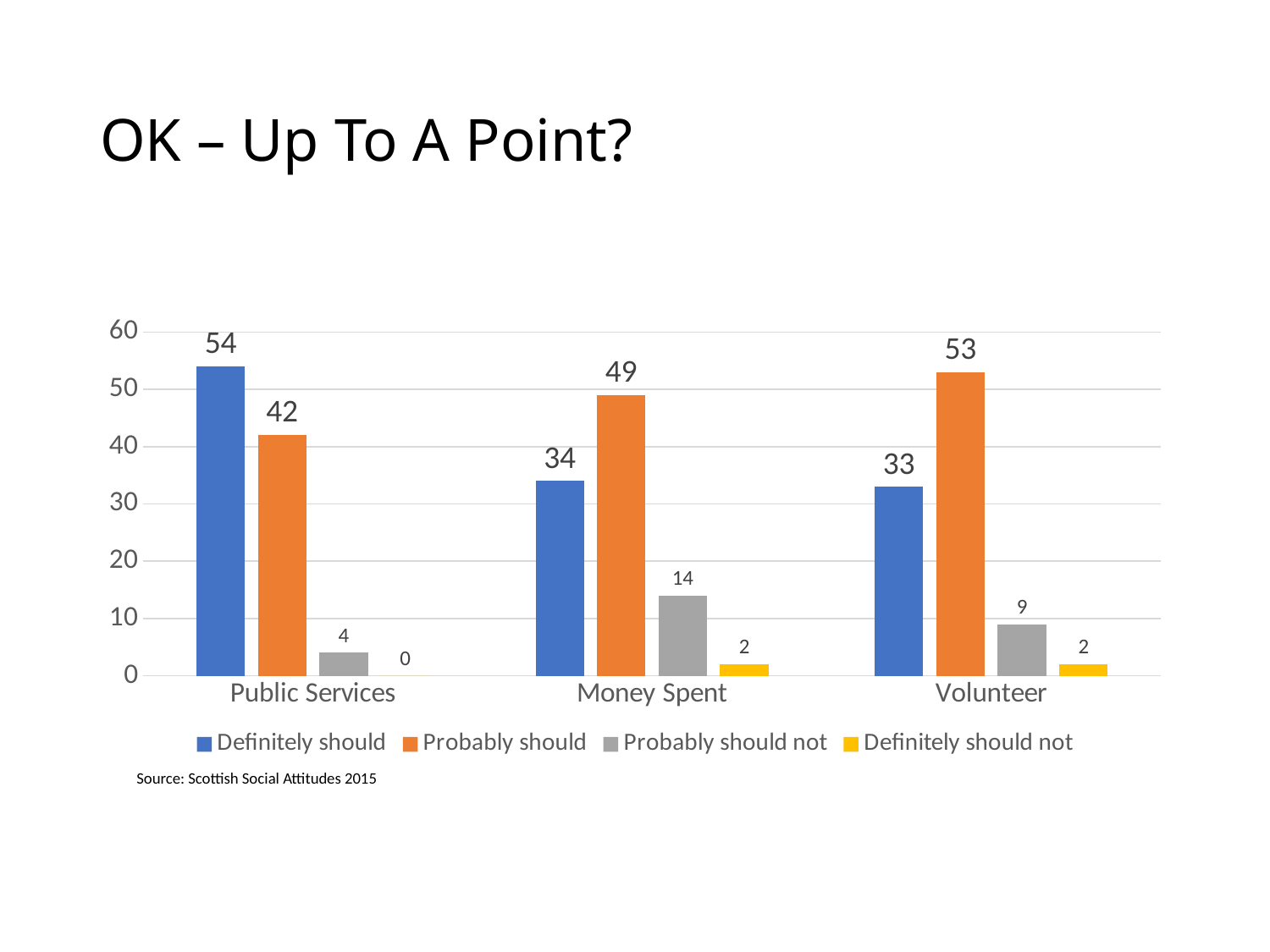
What kind of chart is shown on the slide? Bar chart Which category has the highest value for "Probably should"? Volunteer What is the value for "Definitely should" in the Public Services category? 54 How many categories are shown on the x axis? 3 Which is larger in the Money Spent category: "Definitely should" or "Probably should"? Probably should What is the value for "Definitely should not" in the Public Services category? 0 Which category has the lowest value for "Definitely should"? Volunteer What is the difference between the "Definitely should" and "Probably should" values in the Public Services category? 12 How many series does the legend list? 4 What is the value for "Probably should" in the Money Spent category? 49 What is the value for "Probably should not" in the Volunteer category? 9 What is the source cited below the chart? Scottish Social Attitudes 2015